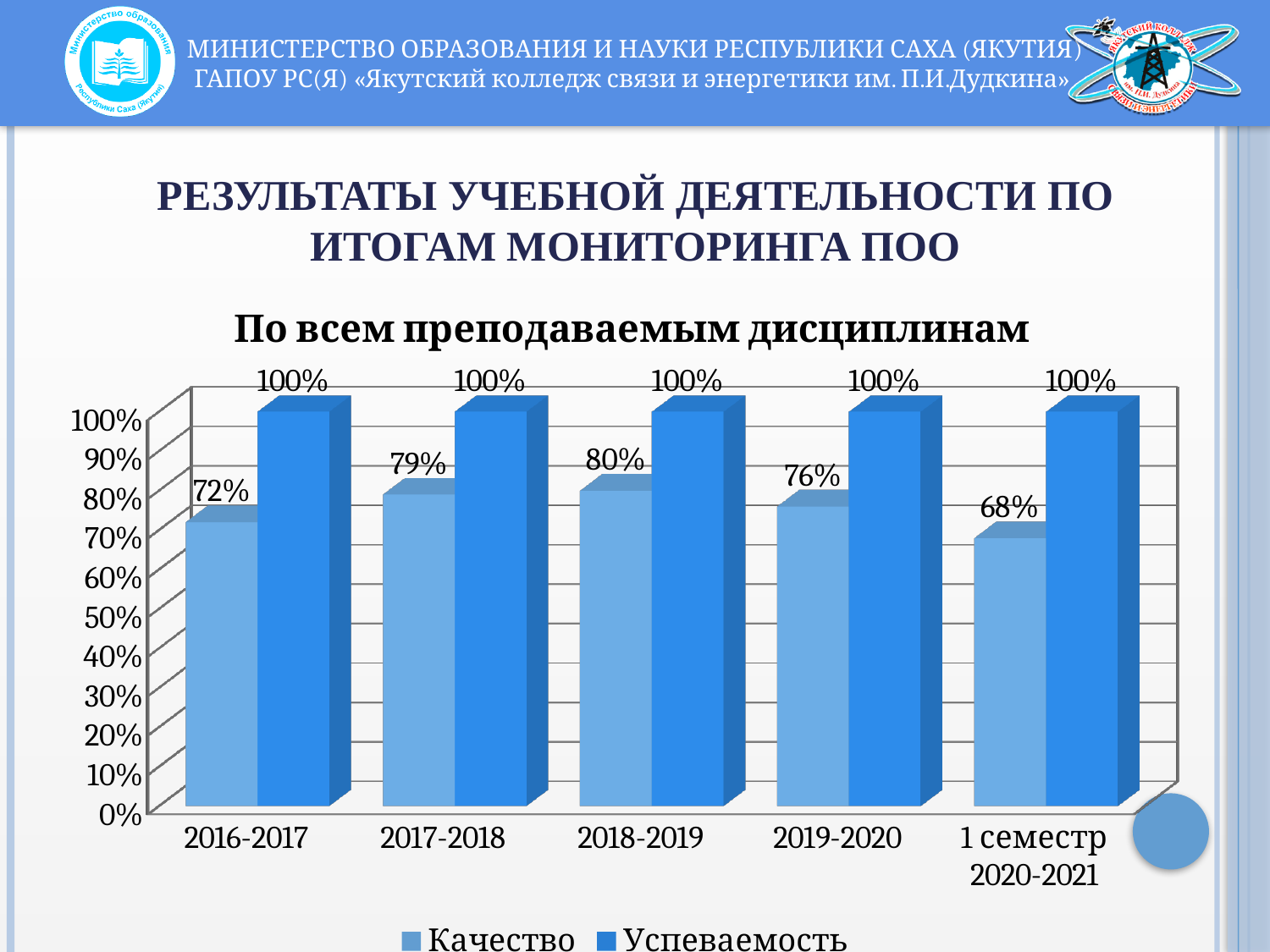
What is the value of Качество for 2016-2017? 72% How many periods are shown on the x axis? 5 How many series does the legend list? 2 What is the value of Качество for 2018-2019? 80% What kind of chart is shown on the slide? Bar chart What is the value of Качество for 2017-2018? 79% What is the value of Качество for 1 семестр 2020-2021? 68% Which period has the lowest Качество value? 1 семестр 2020-2021 What is the value of Успеваемость for 2019-2020? 100% What is the difference between Качество in 2018-2019 and in 1 семестр 2020-2021? 12% Which period has the highest Качество value? 2018-2019 Which is larger, Качество in 2017-2018 or Качество in 2019-2020? 2017-2018